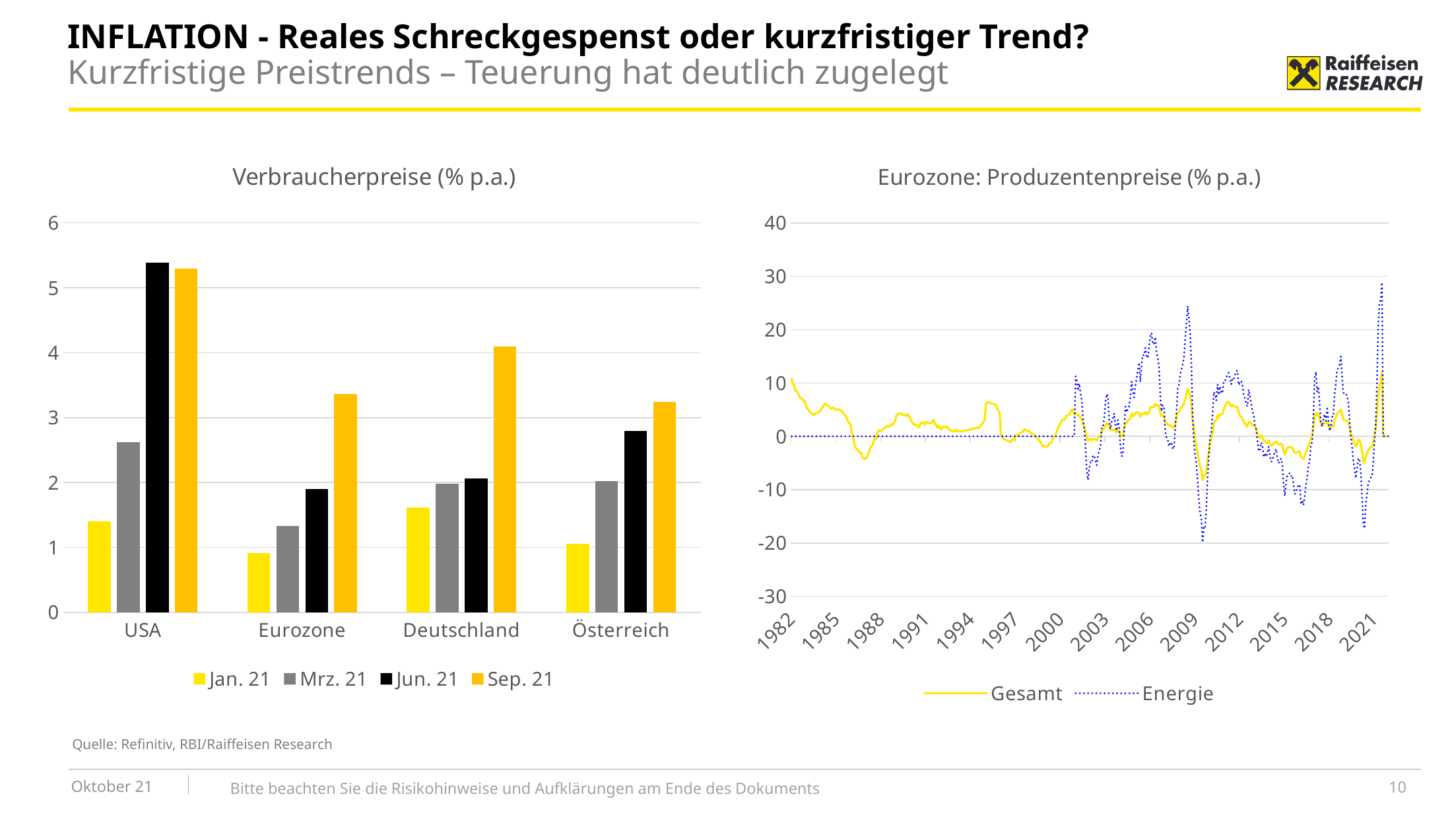
How many series does the legend of the 'Verbraucherpreise (% p.a.)' chart list? 4 In the 'Verbraucherpreise (% p.a.)' chart, which is larger: the Jun. 21 value for Deutschland or the Jun. 21 value for Österreich? Österreich In the 'Verbraucherpreise (% p.a.)' chart, is the Jun. 21 value for USA greater or less than 5? greater In the 'Verbraucherpreise (% p.a.)' chart, is the Sep. 21 value for Eurozone greater or less than 3? greater In the 'Verbraucherpreise (% p.a.)' chart, which category has the highest Sep. 21 value? USA How many series does the legend of the 'Eurozone: Produzentenpreise (% p.a.)' chart list? 2 In the 'Verbraucherpreise (% p.a.)' chart, do the Eurozone values rise or fall from Jan. 21 to Sep. 21? rise How many countries/regions are shown on the x axis of the 'Verbraucherpreise (% p.a.)' chart? 4 In the 'Verbraucherpreise (% p.a.)' chart, which is larger: the Mrz. 21 value for USA or the Mrz. 21 value for Deutschland? USA In the 'Eurozone: Produzentenpreise (% p.a.)' chart, is the peak of the Energie series around 2021 greater or less than 20? greater What kind of chart is the 'Verbraucherpreise (% p.a.)' chart? bar chart What kind of chart is the 'Eurozone: Produzentenpreise (% p.a.)' chart? line chart